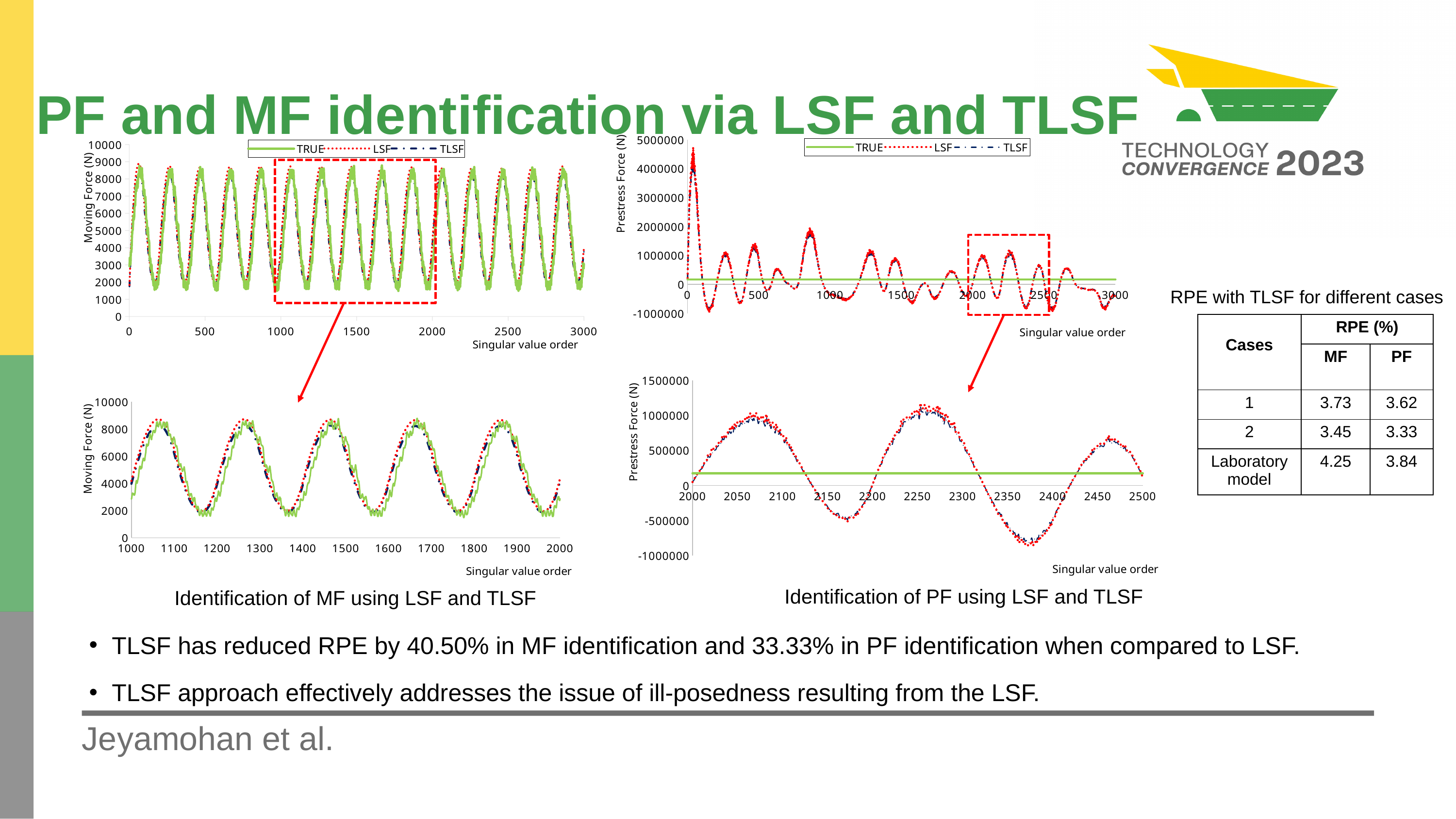
In the top-right Prestress Force chart, is the highest peak of the LSF series near the start greater or less than 4000000? greater In the bottom-right Prestress Force chart (x from 2000 to 2500), is the peak of the LSF series near 2250 greater or less than 1000000? greater In the top-left Moving Force chart, are the peak values of the TRUE series greater or less than 8000? greater In the top-right Prestress Force chart, do the peak heights of the LSF series generally rise or fall as the singular value order increases from 0 to 3000? fall What is the y-axis label of the top-right chart? Prestress Force (N) What is the x-axis range shown on the bottom-left Moving Force chart? 1000 to 2000 How many series does the legend of the top-left Moving Force chart list? 3 What kind of chart is the top-left chart titled 'Identification of MF using LSF and TLSF'? line chart What are the three series named in the legend of the top-right Prestress Force chart? TRUE, LSF, TLSF